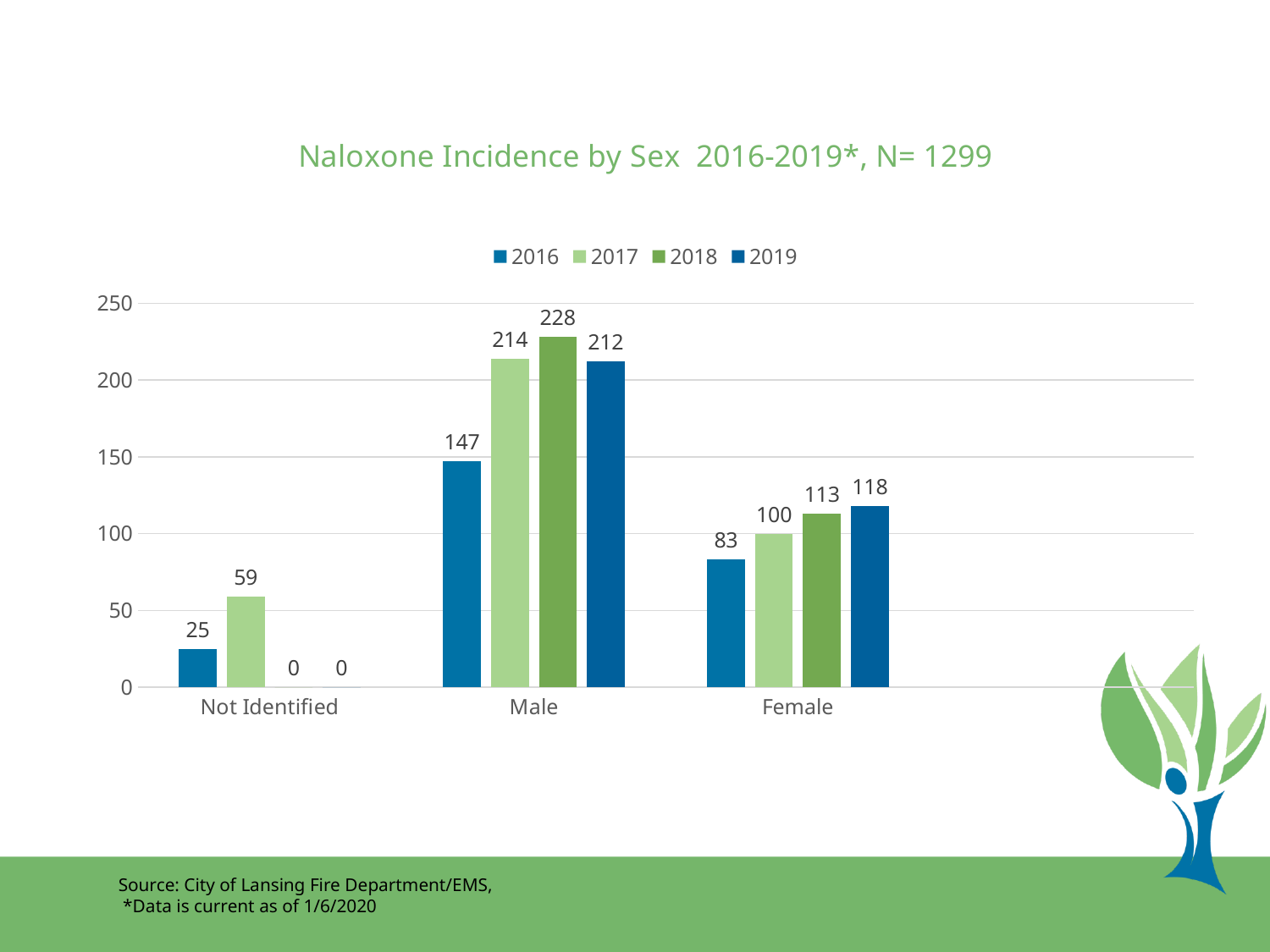
What is the difference between the Male values for 2018 and 2016? 81 How many categories are shown on the x axis? 3 Which year has the lowest value for Male? 2016 What kind of chart is shown? Bar chart How many series does the legend list? 4 What is the value for Male in 2018? 228 What is the title of the chart? Naloxone Incidence by Sex 2016-2019*, N= 1299 Do the Female values rise or fall from 2016 to 2019? Rise What is the value for Not Identified in 2017? 59 Which is larger, the Female value for 2019 or the Female value for 2017? 2019 Which category has the highest value in 2019? Male What is the value for Female in 2016? 83